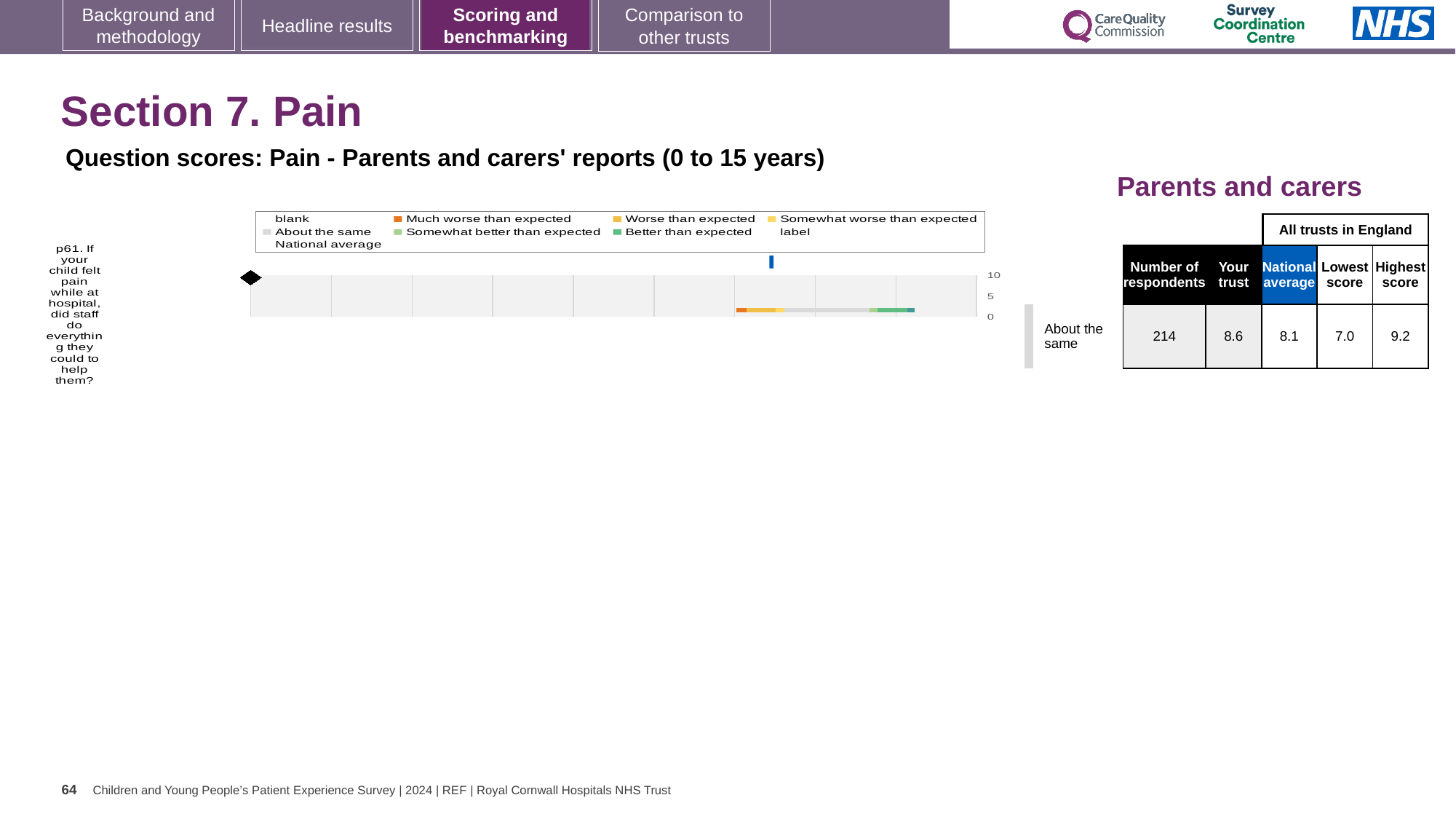
What kind of chart is shown on the slide? bar chart What is the highest value shown on the chart's numeric axis? 10 What benchmark category is shown for question p61 in the Parents and carers table? About the same What is the 'Your trust' score for question p61? 8.6 What is the difference between the highest score and the lowest score for question p61? 2.2 What is the lowest score among all trusts in England for question p61? 7.0 How many respondents are listed for question p61 in the Parents and carers table? 214 What is the highest score among all trusts in England for question p61? 9.2 What is the national average score for question p61? 8.1 By how much does the 'Your trust' score exceed the national average for question p61? 0.5 Which is larger for question p61: the 'Your trust' score or the national average? Your trust Which survey question does the chart on the slide relate to? p61. If your child felt pain while at hospital, did staff do everything they could to help them?